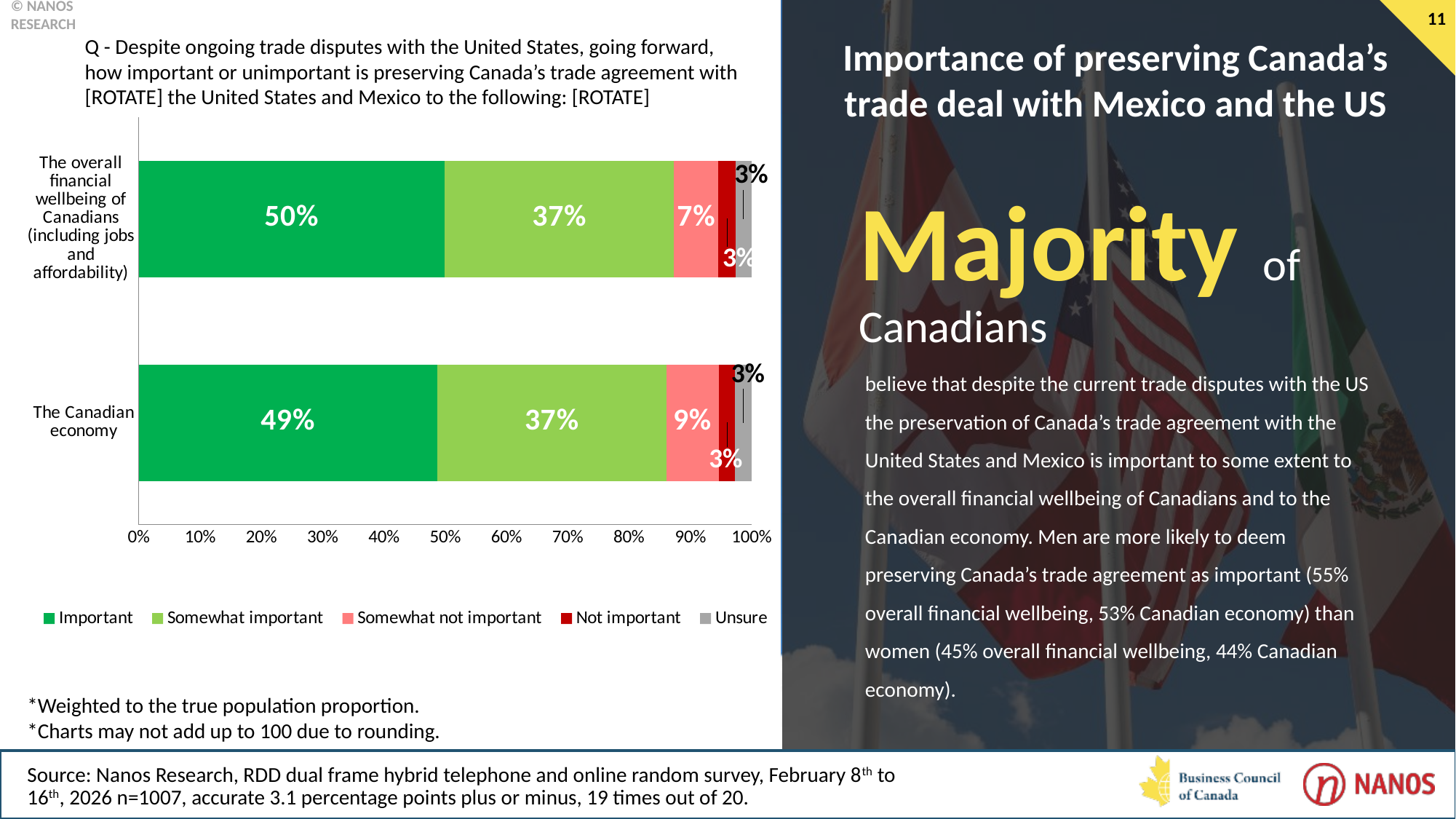
What is the "Unsure" value for the Canadian economy? 3% What percentage rated preserving the trade agreement as "Important" for the Canadian economy? 49% Which category has the larger "Important" share: the overall financial wellbeing of Canadians or the Canadian economy? The overall financial wellbeing of Canadians What is the "Somewhat important" value for the Canadian economy? 37% What is the "Somewhat not important" value for the Canadian economy? 9% What percentage rated preserving the trade agreement as "Important" for the overall financial wellbeing of Canadians? 50% How many series does the legend list? 5 What is the difference between the "Somewhat not important" values for the Canadian economy and the overall financial wellbeing of Canadians? 2% What kind of chart is shown on the slide? Stacked bar chart How many categories are plotted on the chart? 2 Which legend entry is shown in dark green? Important What is the "Somewhat not important" value for the overall financial wellbeing of Canadians? 7%